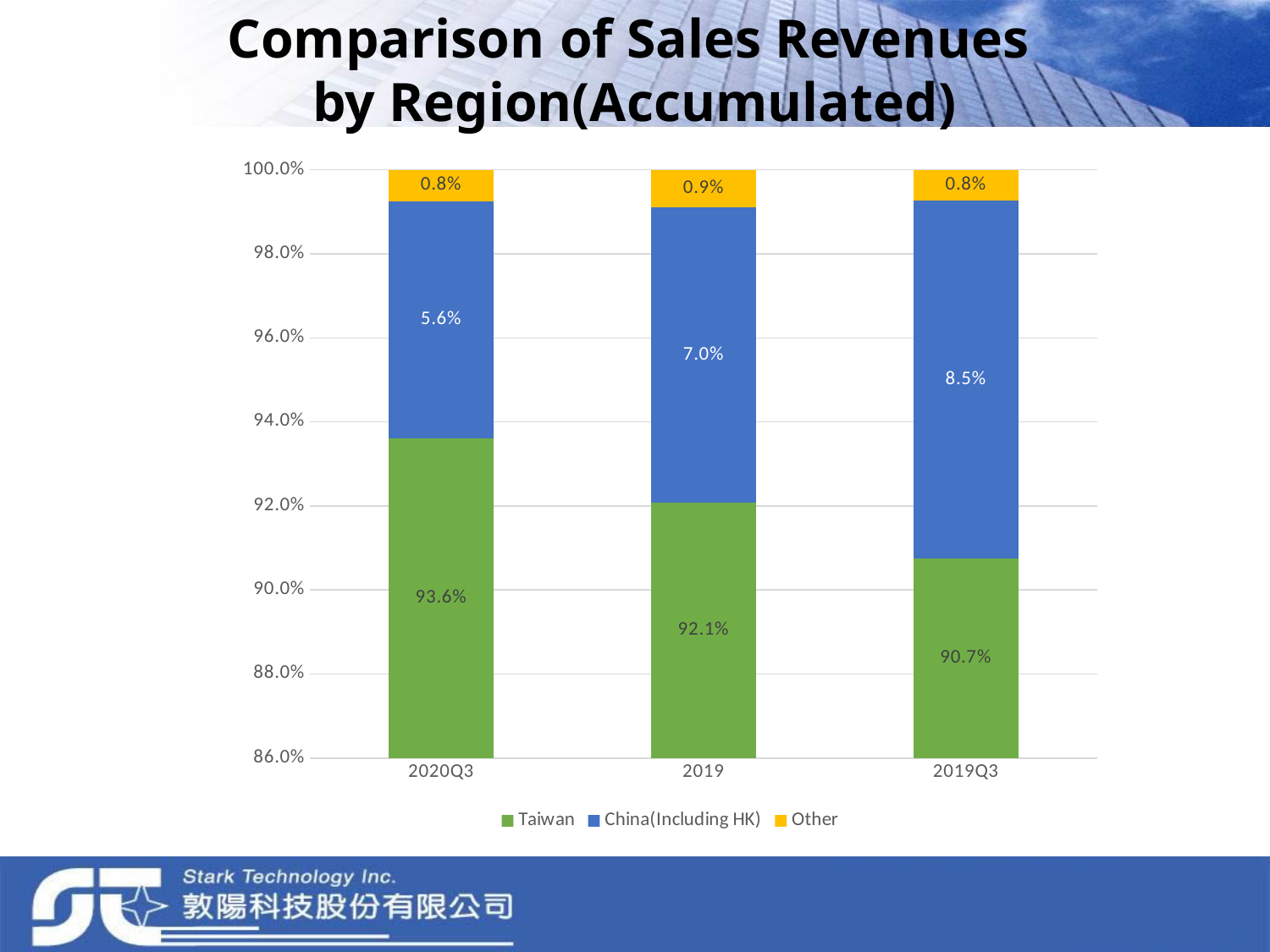
Does the Taiwan share rise or fall from 2020Q3 to 2019Q3 along the x axis? Fall How many periods are shown on the x axis? 3 What is the China(Including HK) share of sales revenue for 2019? 7.0% What is the Taiwan share of sales revenue for 2020Q3? 93.6% Which period has the lowest China(Including HK) share? 2020Q3 How many series does the legend list? 3 Which is larger, the China(Including HK) share in 2019 or in 2019Q3? 2019Q3 What is the difference between the Taiwan share in 2020Q3 and in 2019Q3? 2.9% What is the Other share of sales revenue for 2019Q3? 0.8% What is the China(Including HK) share of sales revenue for 2019Q3? 8.5% Which period has the highest Taiwan share? 2020Q3 What kind of chart is shown on the slide? Stacked bar chart